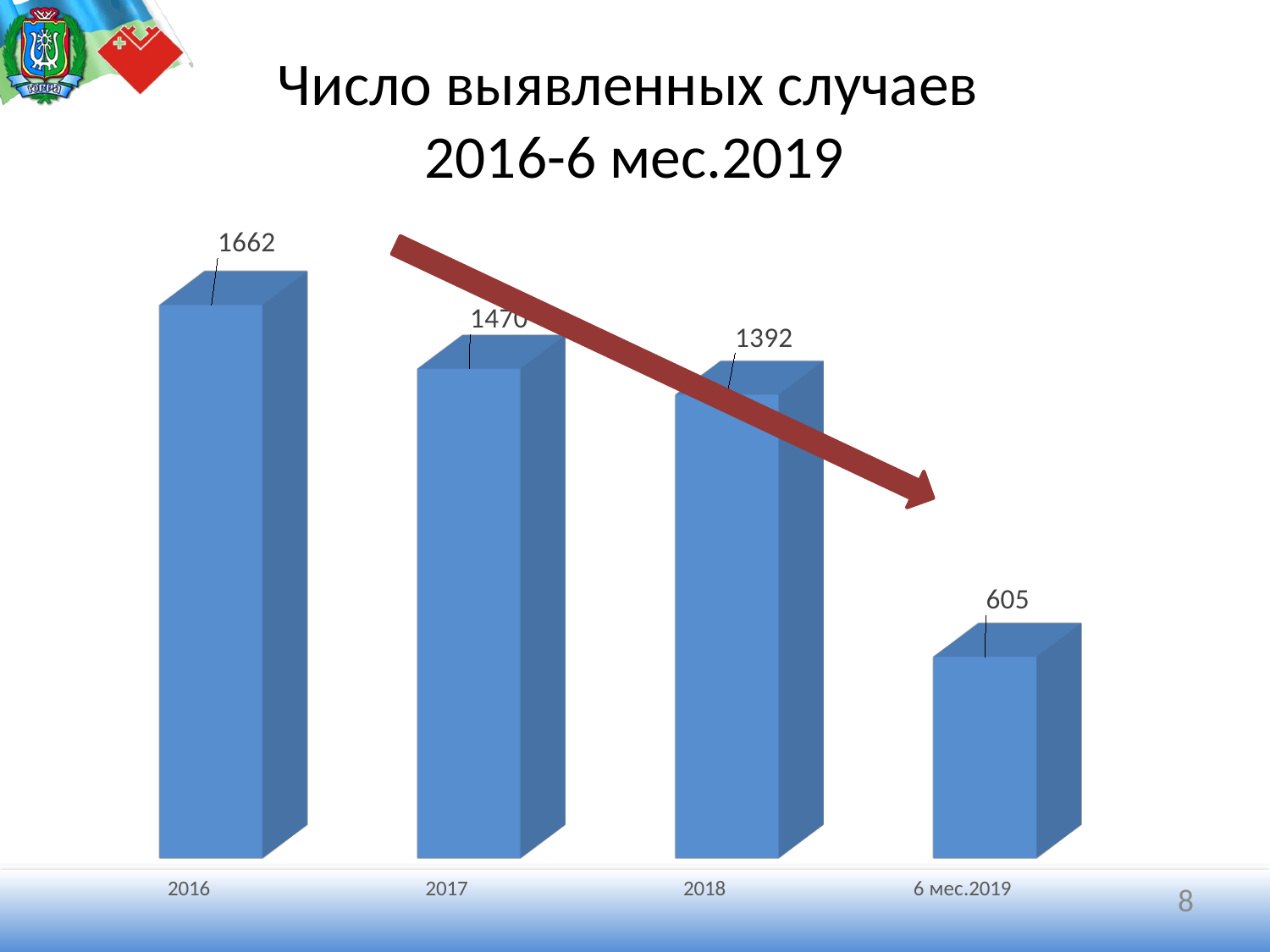
What is the number of detected cases for 2016? 1662 What is the number of detected cases for 2017? 1470 What kind of chart is shown on the slide? bar chart Which is larger, the value for 2017 or the value for 2018? 2017 Which category has the lowest number of detected cases? 6 мес.2019 What is the number of detected cases for 6 мес.2019? 605 What is the difference between the values for 2016 and 2017? 192 Which category has the highest number of detected cases? 2016 What is the number of detected cases for 2018? 1392 What is the difference between the values for 2018 and 6 мес.2019? 787 How many categories are shown on the chart? 4 Do the values rise or fall from 2016 to 6 мес.2019? fall